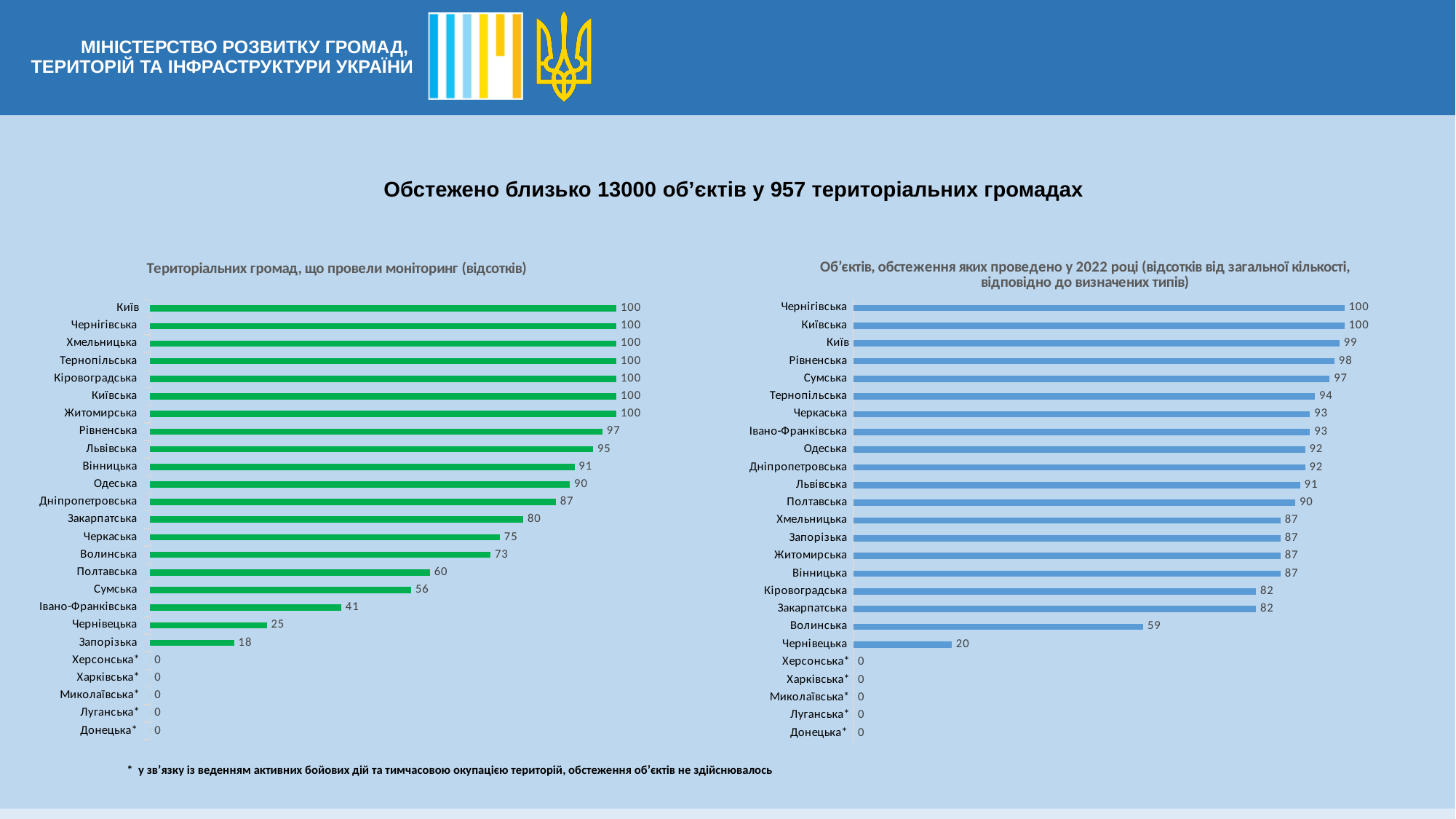
In the right chart (Об'єктів, обстеження яких проведено у 2022 році), which category has the lowest non-zero value? Чернівецька In the left chart (Територіальних громад, що провели моніторинг), what is the value for Полтавська? 60 In the right chart (Об'єктів, обстеження яких проведено у 2022 році), what is the value for Сумська? 97 How many categories are listed in the left chart (Територіальних громад, що провели моніторинг)? 25 In the left chart (Територіальних громад, що провели моніторинг), which has a larger value, Сумська or Івано-Франківська? Сумська In the right chart (Об'єктів, обстеження яких проведено у 2022 році), what is the difference between the values for Київ and Чернівецька? 79 In the right chart (Об'єктів, обстеження яких проведено у 2022 році), what is the value for Волинська? 59 In the right chart (Об'єктів, обстеження яких проведено у 2022 році), which has a larger value, Закарпатська or Полтавська? Полтавська In the left chart (Територіальних громад, що провели моніторинг), what is the value for Запорізька? 18 What type of chart is the right chart (Об'єктів, обстеження яких проведено у 2022 році)? Bar chart In the left chart (Територіальних громад, що провели моніторинг), what is the difference between the values for Львівська and Черкаська? 20 What colour are the bars in the left chart (Територіальних громад, що провели моніторинг)? Green